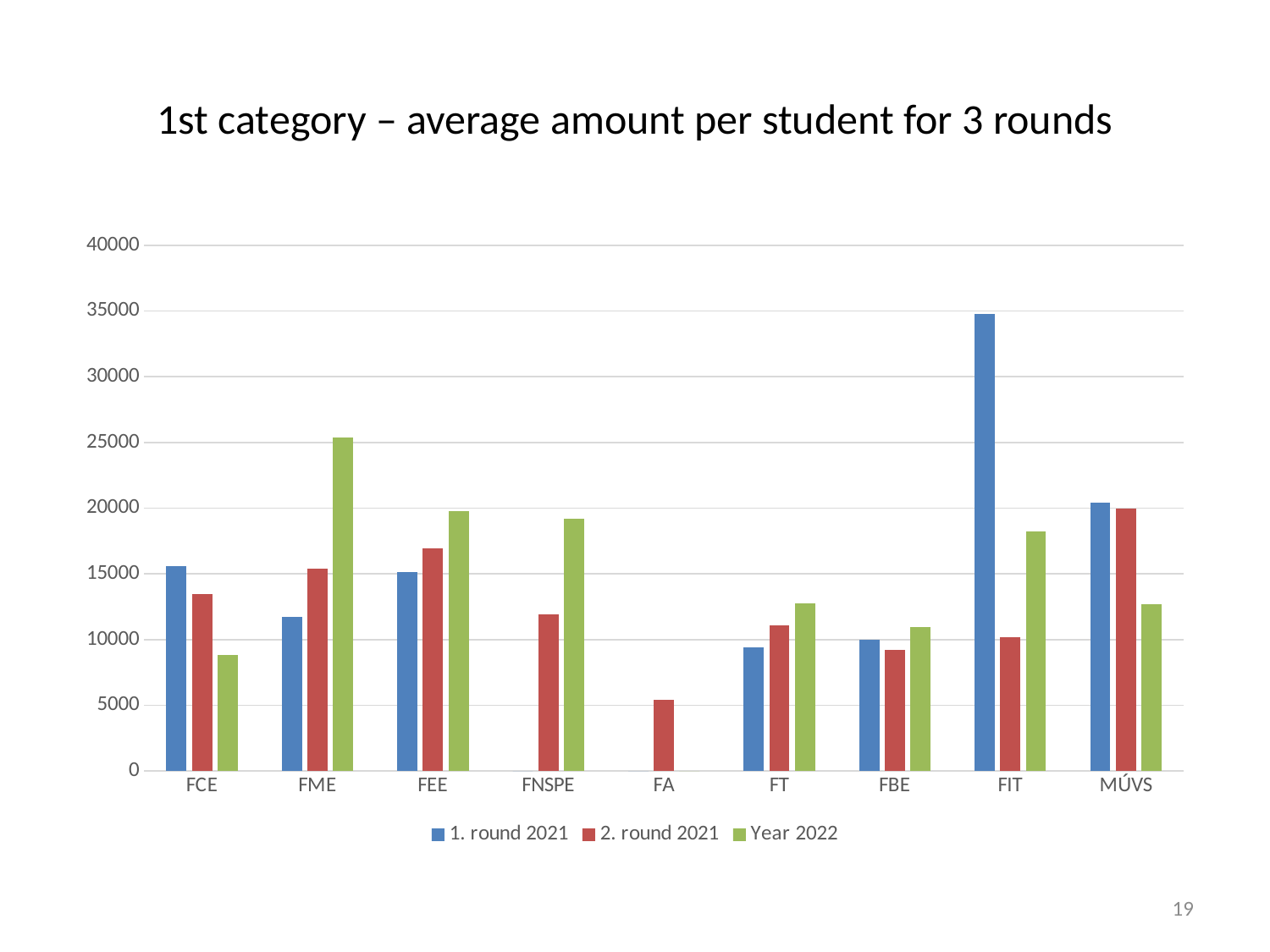
Which category has the highest value for 1. round 2021? FIT How many series does the legend list? 3 Which category has the highest value for Year 2022? FME How many categories are shown on the x axis? 9 What kind of chart is shown on the slide? bar chart Is the value for FIT in 1. round 2021 greater or less than 30000? greater For FEE, which is larger: the value for 2. round 2021 or for Year 2022? Year 2022 Is the value for FA in 2. round 2021 greater or less than 10000? less What is the title of the chart? 1st category – average amount per student for 3 rounds For FCE, which is larger: the value for 1. round 2021 or for Year 2022? 1. round 2021 Which category has the lowest value for 2. round 2021? FA Is the value for FME in Year 2022 greater or less than 20000? greater